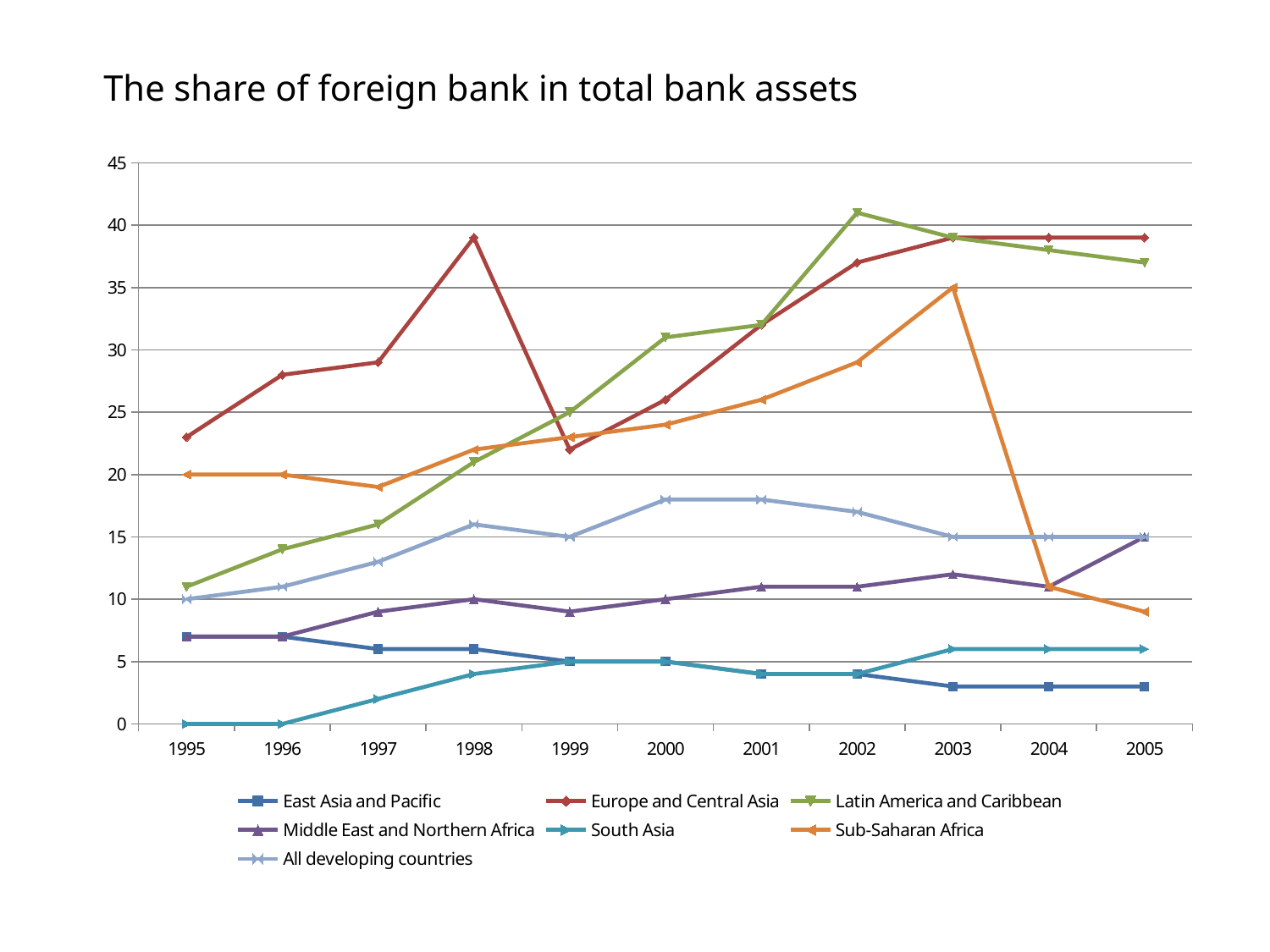
What is the value for Sub-Saharan Africa in 1995? 20 Is the value for Europe and Central Asia in 1998 greater or less than 35? greater Which series has the lowest value in 2005? East Asia and Pacific What is the value for All developing countries in 2005? 15 What kind of chart is shown on the slide? line chart Which series has the highest value in 1995? Europe and Central Asia How many series does the legend list? 7 Does the value for Sub-Saharan Africa rise or fall from 2003 to 2005? fall What is the value for South Asia in 1996? 0 Is the value for Sub-Saharan Africa in 2005 greater or less than 10? less How many years are shown on the x axis? 11 In 2002, which is larger: Latin America and Caribbean or Sub-Saharan Africa? Latin America and Caribbean